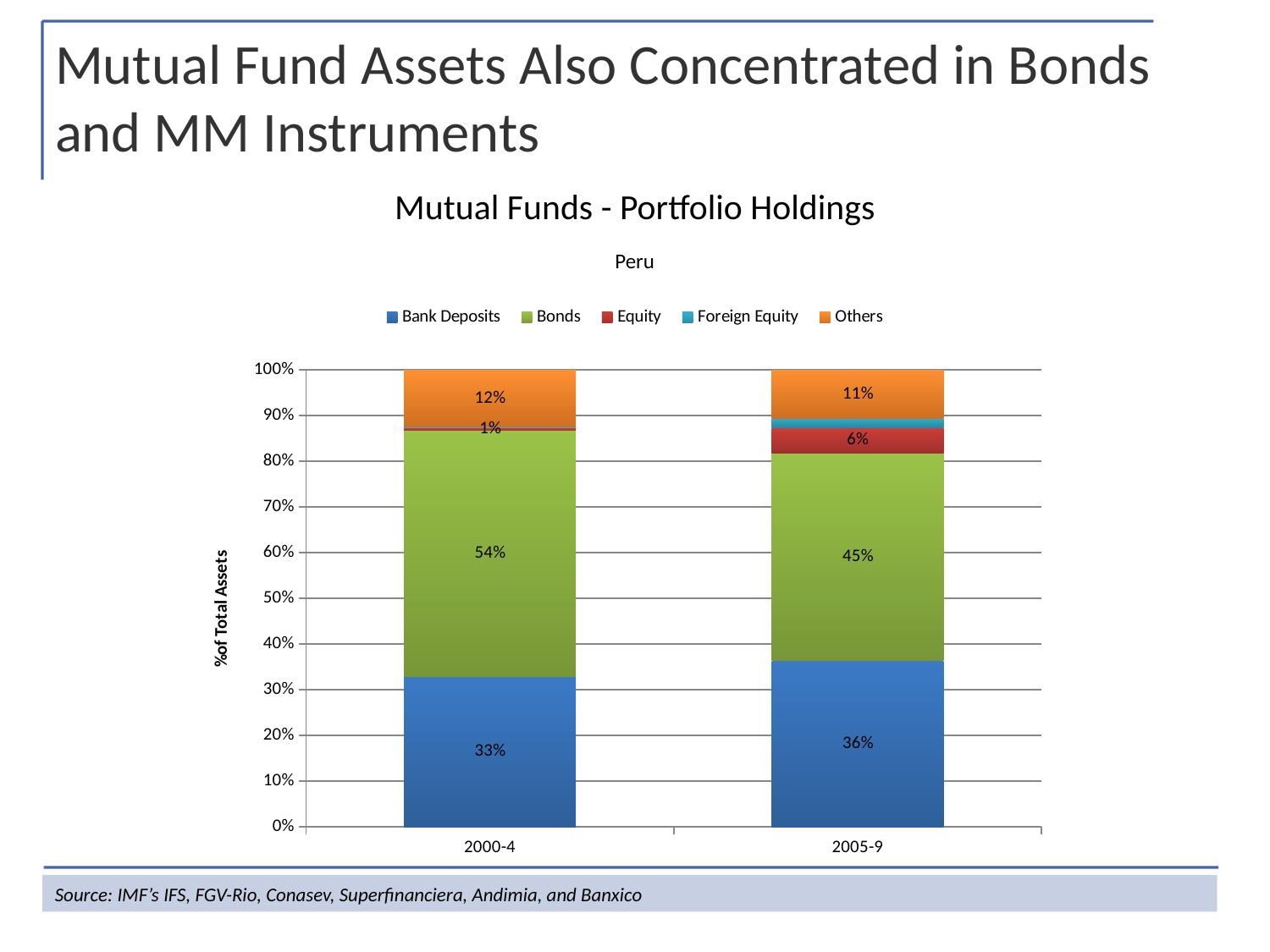
What percentage of total assets was held in Bank Deposits in 2005-9? 36% What percentage of total assets was held in Bonds in 2000-4? 54% What kind of chart is shown on the slide? Stacked bar chart By how many percentage points did the Bonds share fall from 2000-4 to 2005-9? 9 percentage points What is the Equity share of total assets in 2005-9? 6% Is the Foreign Equity share in 2005-9 greater or less than 10%? less How many time periods are shown on the x axis? 2 Which asset class has the largest share in the 2005-9 bar? Bonds What is the Equity share of total assets in 2000-4? 1% Which is larger: the Bank Deposits share in 2000-4 or in 2005-9? 2005-9 What is the Others share of total assets in 2000-4? 12% How many series does the legend list? 5